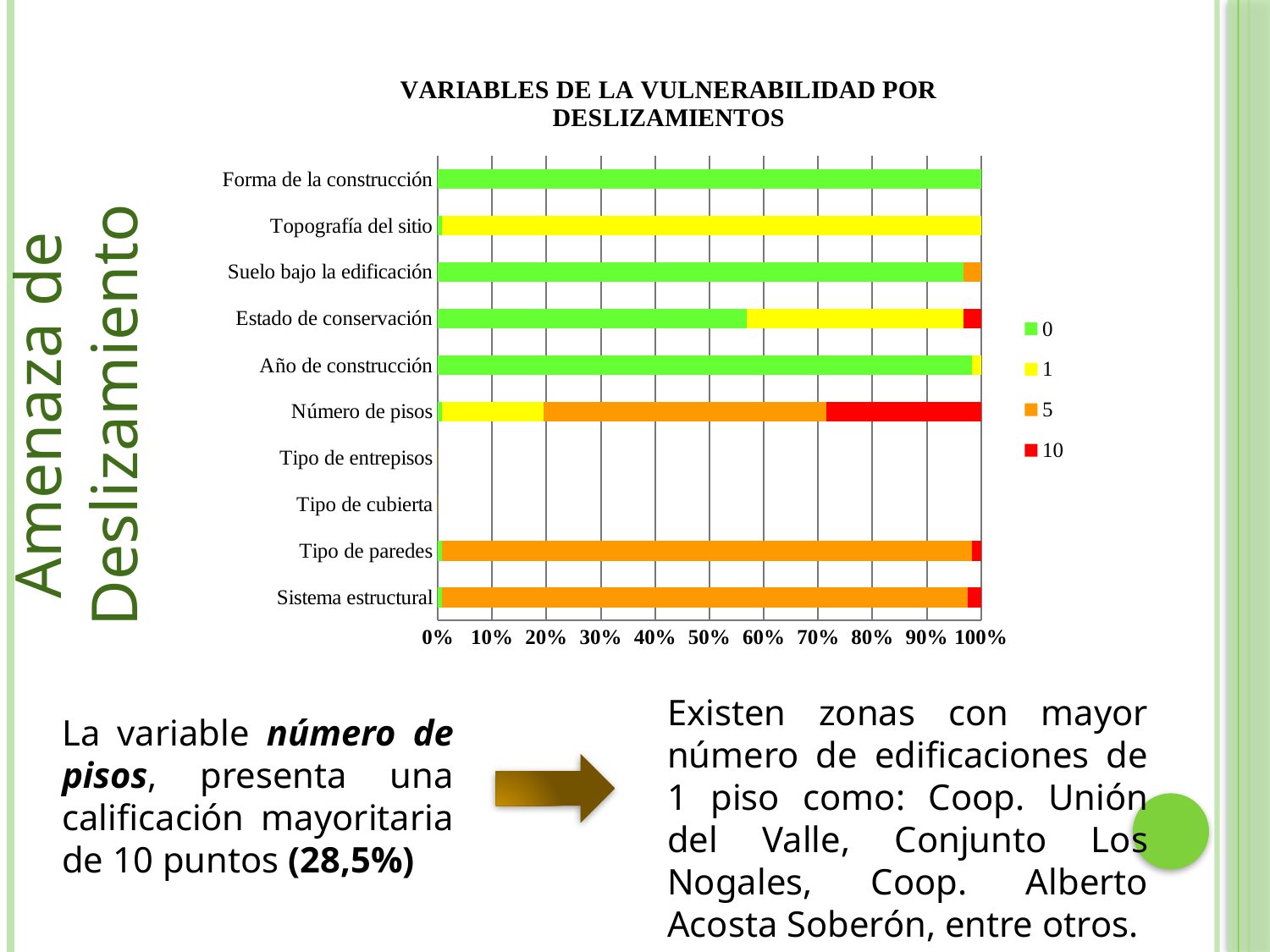
What is the title of the chart? VARIABLES DE LA VULNERABILIDAD POR DESLIZAMIENTOS Which series makes up almost the entire bar for Topografía del sitio? 1 Which category has the largest share for the series 10 (red)? Número de pisos Which series makes up the entire bar for Forma de la construcción? 0 Which two categories have no bar plotted? Tipo de entrepisos and Tipo de cubierta Is the share of series 5 (orange) for Tipo de paredes greater or less than 90%? greater Is the share of series 10 (red) for Número de pisos greater or less than 20%? greater What kind of chart is shown on the slide? Stacked bar chart How many categories are listed on the vertical axis of the chart? 10 How many series does the legend list? 4 Which legend entry is shown in red? 10 Is the share of series 0 (green) for Estado de conservación greater or less than 50%? greater